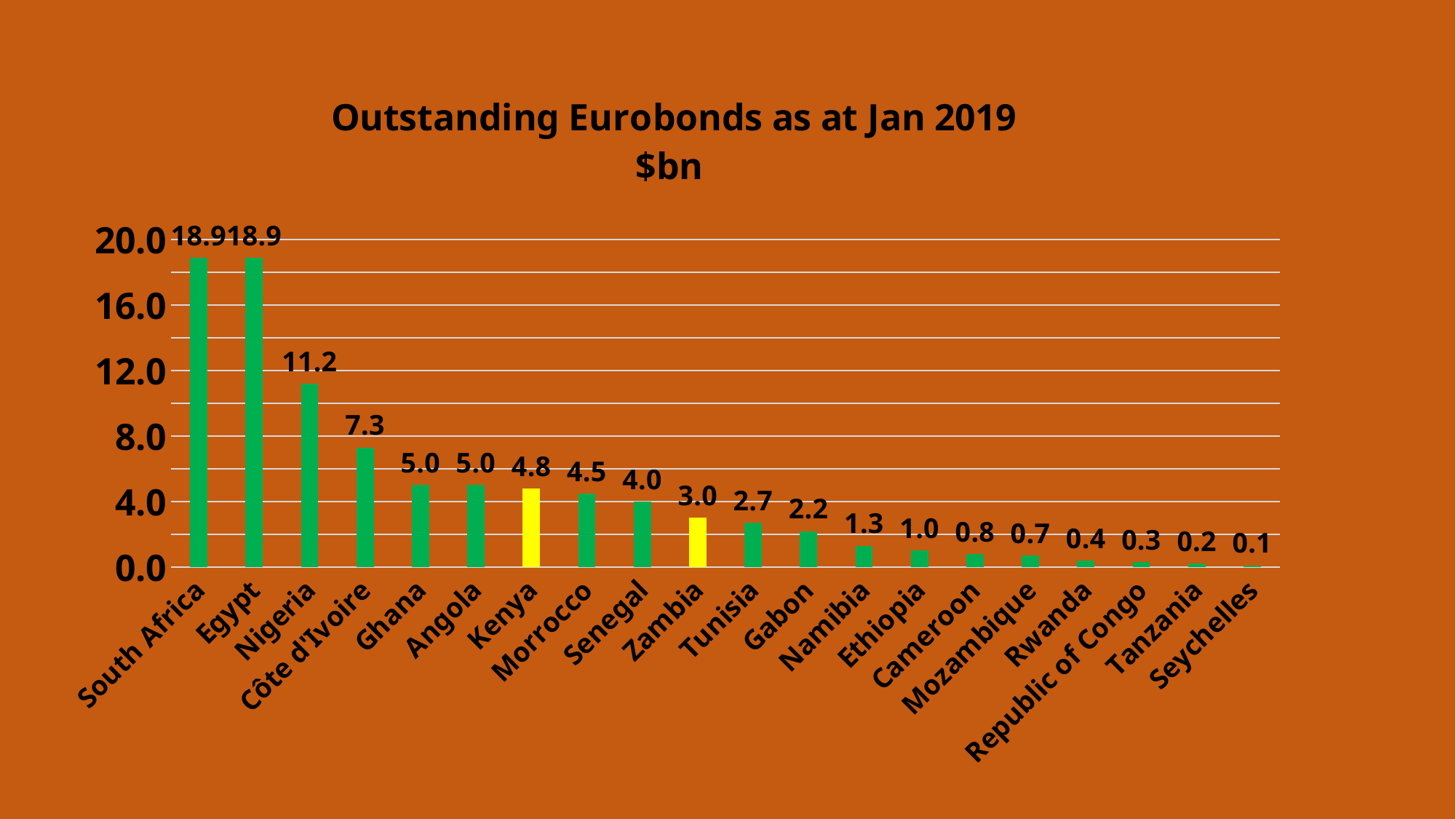
Which is larger, the value for Senegal or the value for Gabon? Senegal Which country has the lowest outstanding Eurobonds? Seychelles What is the value for Rwanda? 0.4 What is the difference between the values for Nigeria and Côte d'Ivoire? 3.9 What kind of chart is shown on the slide? Bar chart What is the difference between the values for Zambia and Tunisia? 0.3 How many countries are shown on the chart? 20 What is the value for Côte d'Ivoire? 7.3 Which two countries have bars coloured yellow instead of green? Kenya and Zambia What is the value for Nigeria? 11.2 What is the value for Kenya? 4.8 Is the value for Egypt greater or less than 16.0? greater